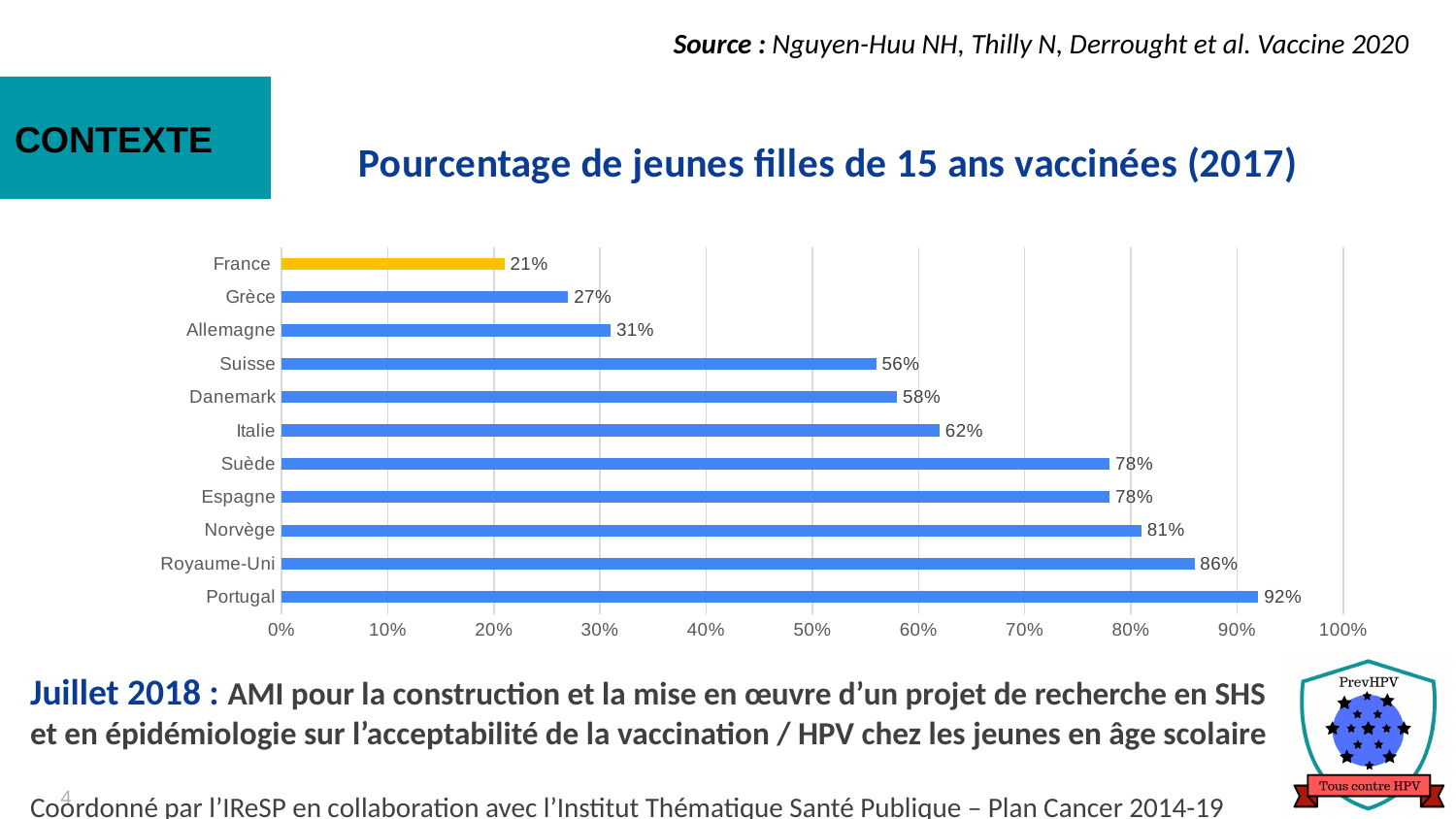
Which country's bar is coloured differently (yellow) from the others? France What is the difference between the values for Italie and Suisse? 6% What is the difference between the values for Portugal and France? 71% Which is larger, the value for Norvège or the value for Allemagne? Norvège What kind of chart is shown on the slide? bar chart Is the value for Grèce greater or less than 30%? less Which country has the highest percentage? Portugal What is the value for Danemark? 58% What is the value for France? 21% How many countries are shown in the chart? 11 Which country has the lowest percentage? France What is the value for Royaume-Uni? 86%